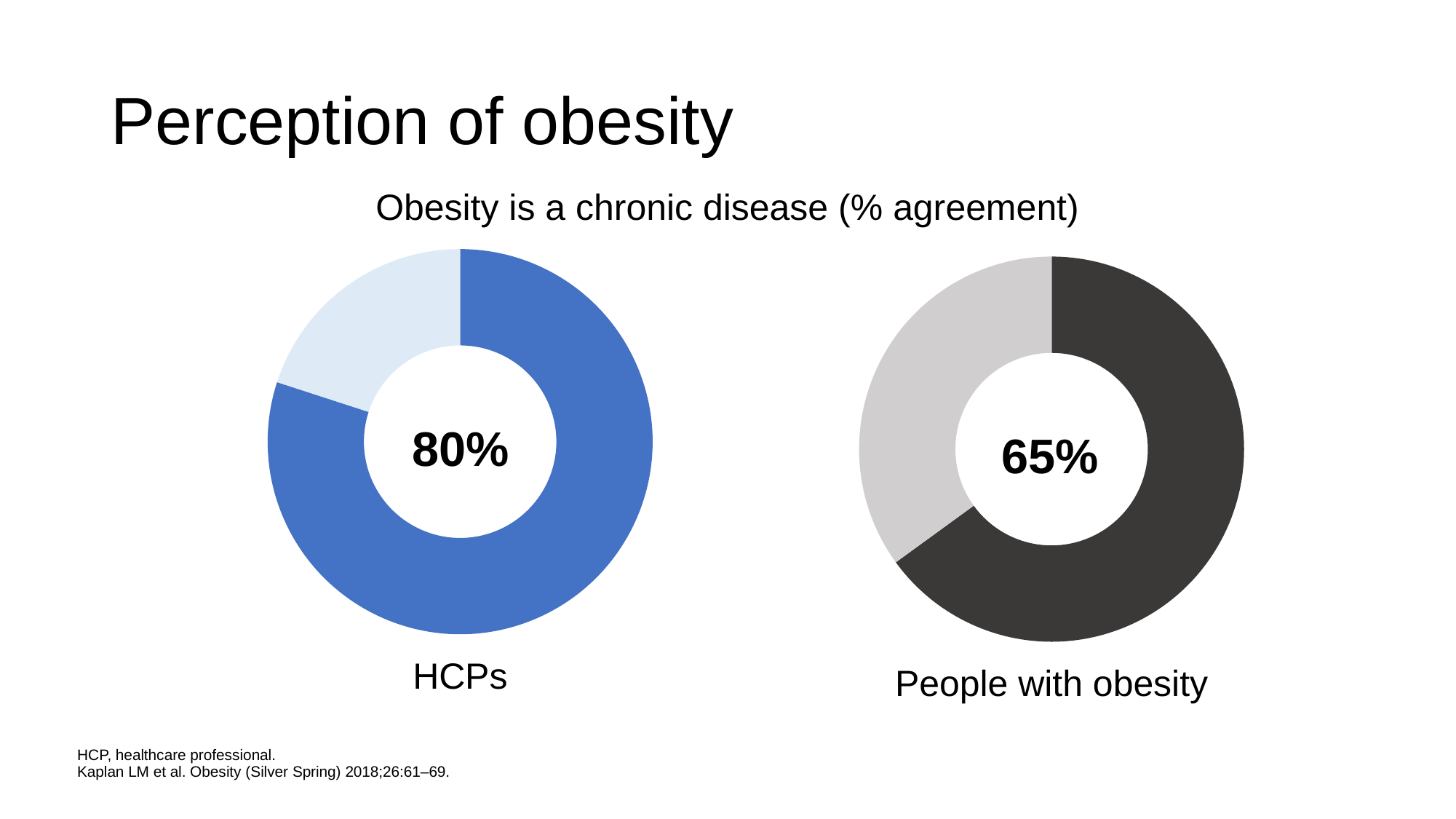
What is the shared title above the two doughnut charts? Obesity is a chronic disease (% agreement) What kind of chart is used to show the HCPs agreement? Doughnut chart Is the agreement value in the People with obesity chart greater or less than 50%? greater In the People with obesity chart, what share of the doughnut does the dark grey segment represent? 65% In the HCPs chart, what share of the doughnut does the dark blue segment represent? 80% Which chart shows the lowest percentage agreement? People with obesity Which group shows higher agreement that obesity is a chronic disease, HCPs or people with obesity? HCPs What percentage of people with obesity agree that obesity is a chronic disease, according to the People with obesity chart? 65% What colour is the larger segment in the HCPs chart? Blue What is the difference in percentage agreement between the HCPs chart and the People with obesity chart? 15% What percentage of HCPs agree that obesity is a chronic disease, according to the HCPs chart? 80% How many doughnut charts are shown on the slide? 2